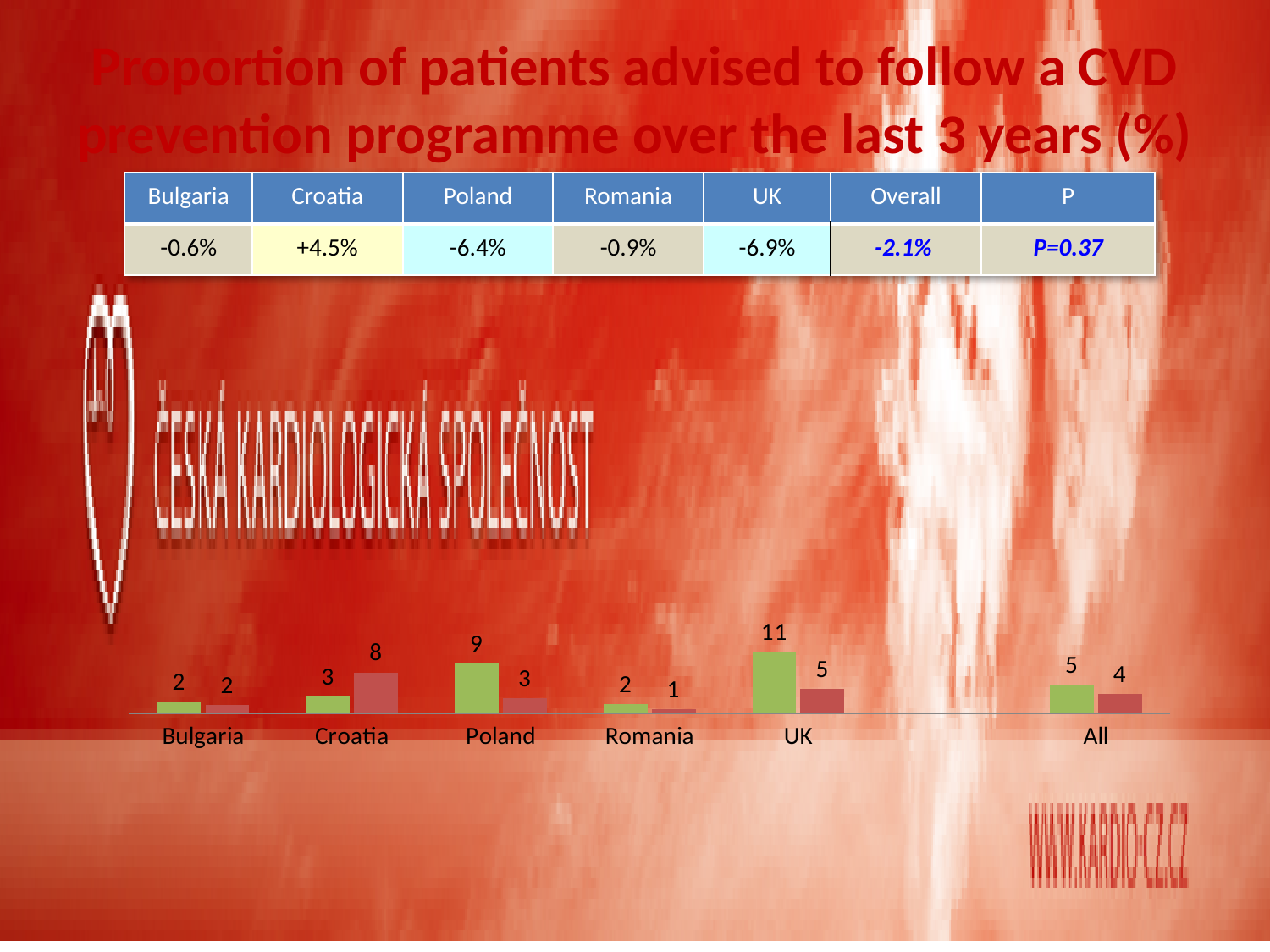
Which category has the highest green bar? UK How many categories are shown along the x axis of the chart? 6 What is the value of the green bar for the UK? 11 What is the value of the green bar for All? 5 What is the difference between the green bar and the red bar for the UK? 6 What is the difference between the green bar for Poland and the green bar for Croatia? 6 What is the value of the red bar for Croatia? 8 What is the value of the green bar for Poland? 9 Which category has the lowest red bar? Romania What type of chart is shown on the slide? bar chart What is the value of the red bar for Romania? 1 For Croatia, which is larger: the green bar or the red bar? the red bar